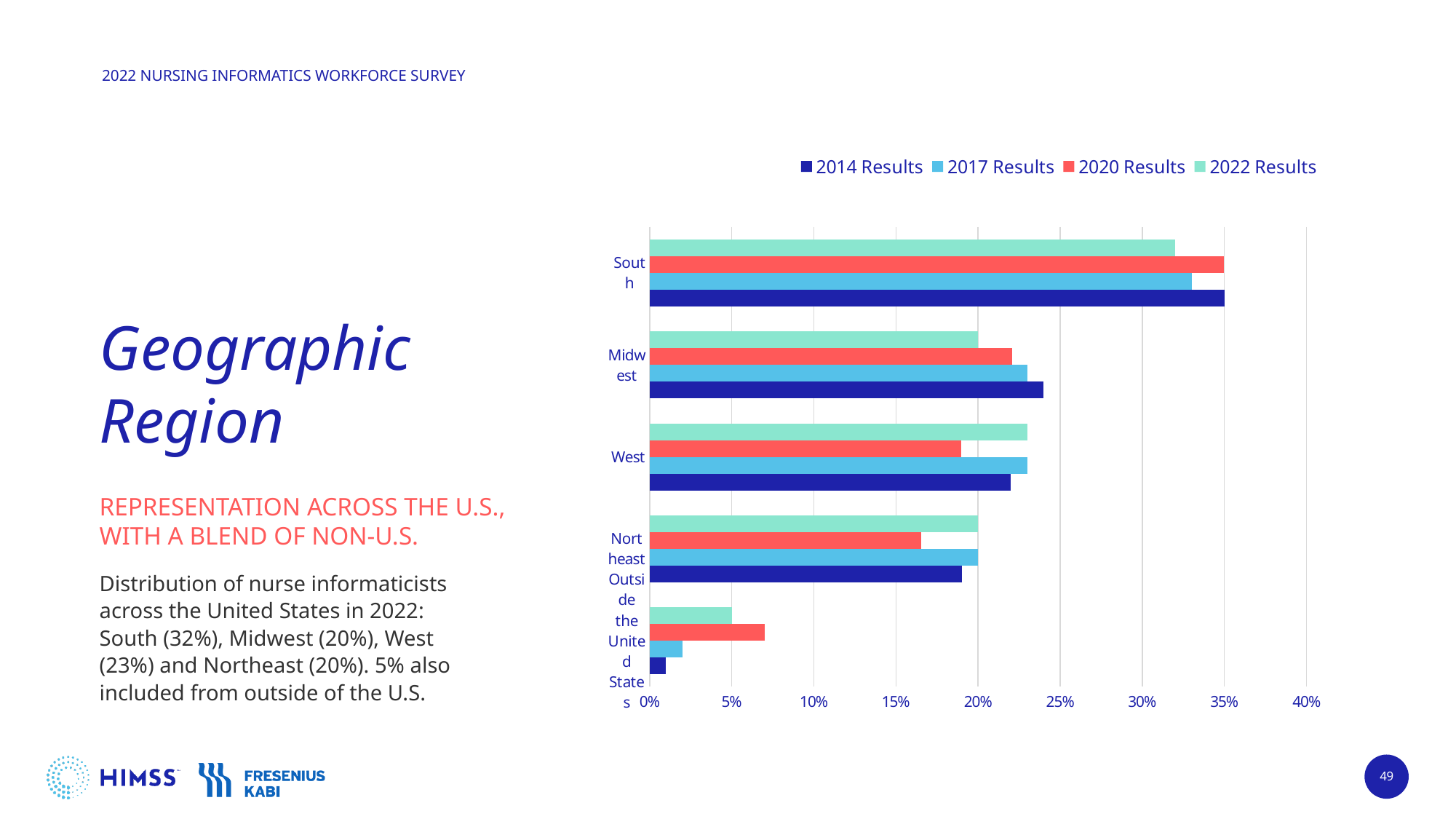
Which region has the highest 2022 Results value? South Is the 2020 Results value for Northeast greater or less than 20%? less Which category has the lowest 2022 Results value? Outside the United States How many geographic region categories are plotted on the chart? 5 In the 2022 Results, which is larger: West or Midwest? West What kind of chart is shown on the slide? Bar chart What is the difference between the 2022 Results values for South and Midwest? 12 percentage points How many series does the chart legend list? 4 What is the 2022 Results value for Outside the United States? 5% What is the 2022 Results value for West? 23% Is the 2020 Results value for South greater or less than 30%? greater What is the 2022 Results value for South? 32%